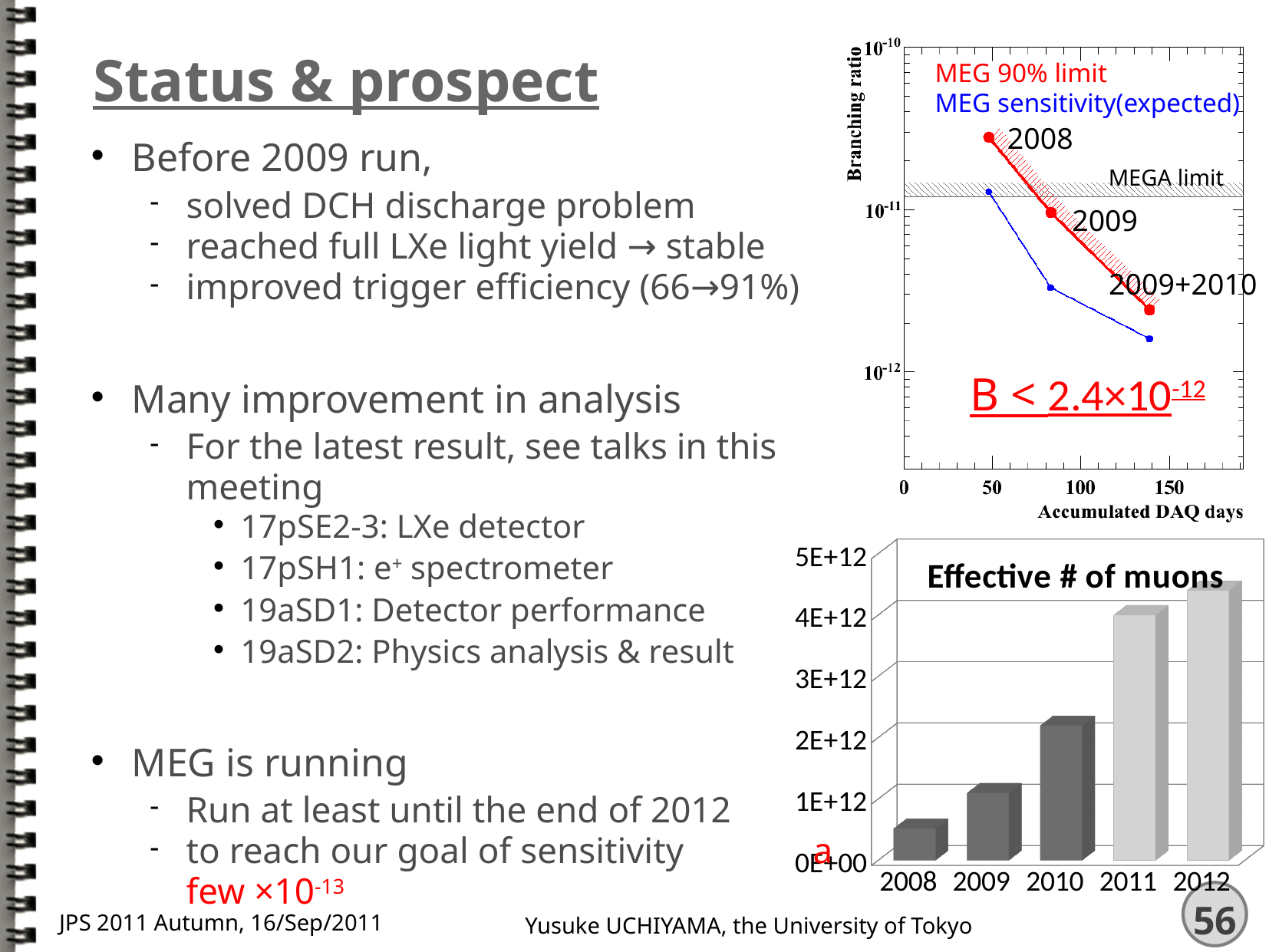
In the branching ratio chart at the top right, does the MEG 90% limit rise or fall as accumulated DAQ days increase? fall In the 'Effective # of muons' chart, is the value for 2010 greater or less than 1E+12? greater In the branching ratio chart at the top right, how many series are listed in the legend? 2 In the 'Effective # of muons' chart, do the bars rise or fall from 2008 to 2012? rise In the 'Effective # of muons' chart, which year has the lowest bar? 2008 In the 'Effective # of muons' chart, is the value for 2011 greater or less than 3E+12? greater In the branching ratio chart at the top right, what colour is the MEG sensitivity(expected) line? blue In the 'Effective # of muons' chart, how many years are shown on the x axis? 5 What kind of chart is the 'Effective # of muons' chart? bar chart In the 'Effective # of muons' chart, is the value for 2008 greater or less than 1E+12? less In the 'Effective # of muons' chart, which year has the highest bar? 2012 In the 'Effective # of muons' chart, which is larger, the value for 2009 or the value for 2011? 2011